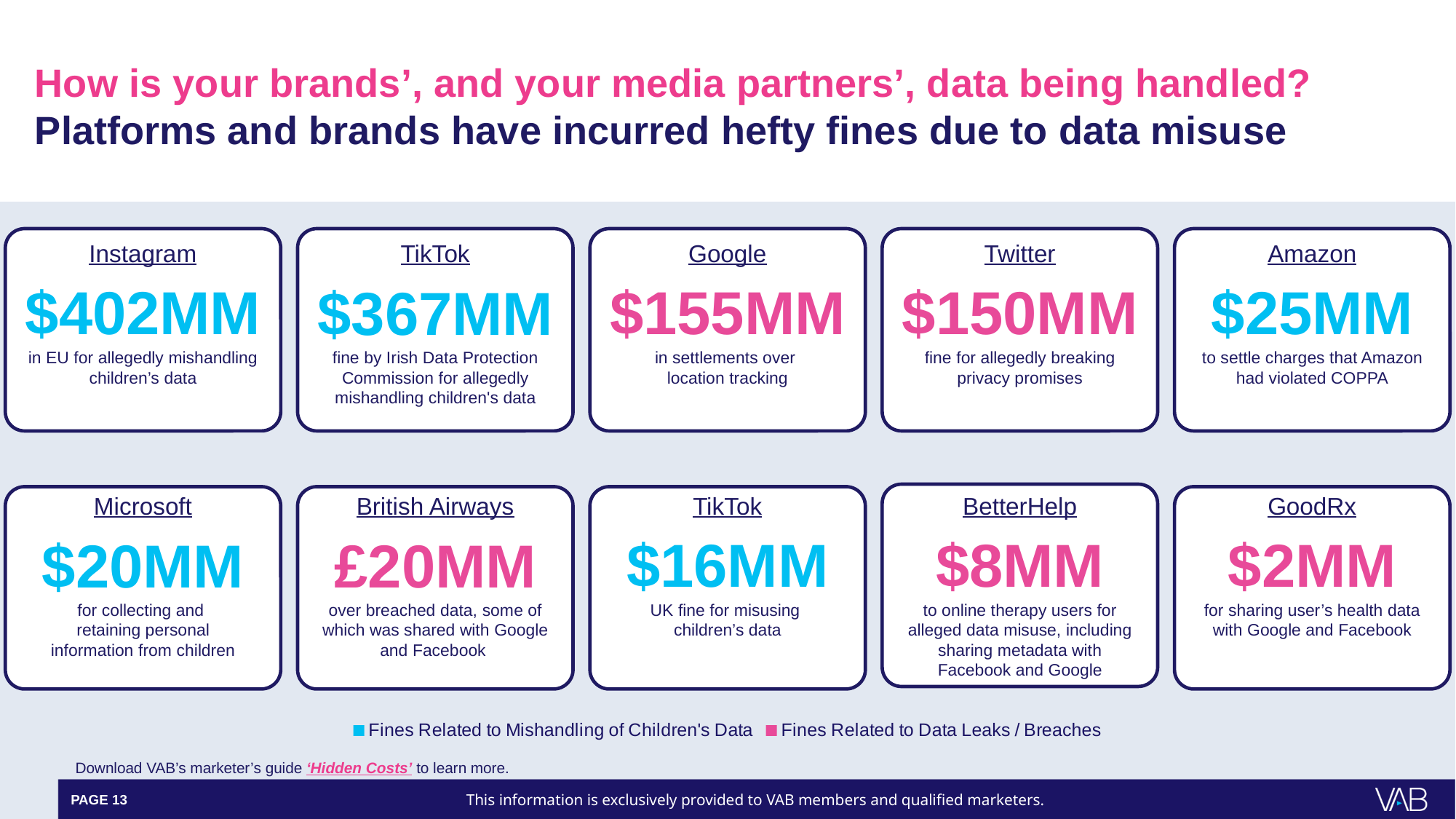
Which company has the largest fine shown on the slide? Instagram Which is larger, the Amazon fine or the Microsoft fine? Amazon What is the difference between the Instagram fine and the TikTok $367MM fine? $35MM What is the difference between the Google fine and the Twitter fine? $5MM What fine amount is shown for BetterHelp? $8MM What fine amount is shown for Google? $155MM How many categories does the legend list? 2 Which legend category is shown in pink? Fines Related to Data Leaks / Breaches How many fine cards are shown on the slide? 10 What fine amount is shown for Instagram? $402MM Which company has the smallest fine shown on the slide? GoodRx What fine amount is shown for British Airways? £20MM